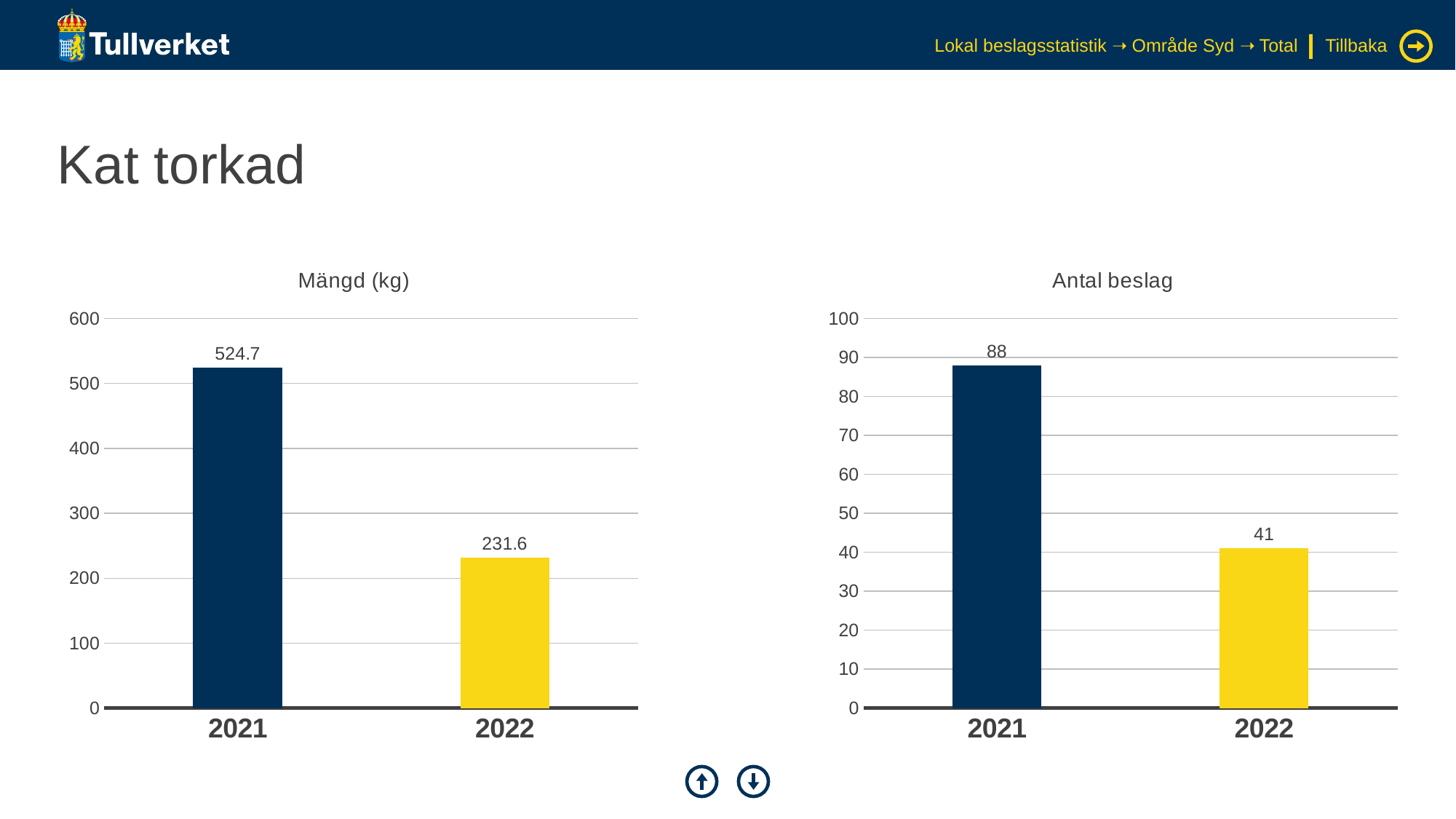
In the 'Antal beslag' chart, what is the value for 2022? 41 In the 'Antal beslag' chart, is the value for 2021 larger or smaller than the value for 2022? larger In the 'Mängd (kg)' chart, what is the value for 2021? 524.7 In the 'Mängd (kg)' chart, is the value for 2022 greater or less than 300? less In the 'Mängd (kg)' chart, what is the difference between the 2021 and 2022 values? 293.1 In the 'Antal beslag' chart, what is the difference between the 2021 and 2022 values? 47 In the 'Antal beslag' chart, what is the value for 2021? 88 In the 'Mängd (kg)' chart, which year has the highest value? 2021 In the 'Mängd (kg)' chart, what is the value for 2022? 231.6 In the 'Antal beslag' chart, which year has the lowest value? 2022 What kind of chart is the 'Mängd (kg)' chart? bar chart How many categories are shown on the x axis of the 'Antal beslag' chart? 2